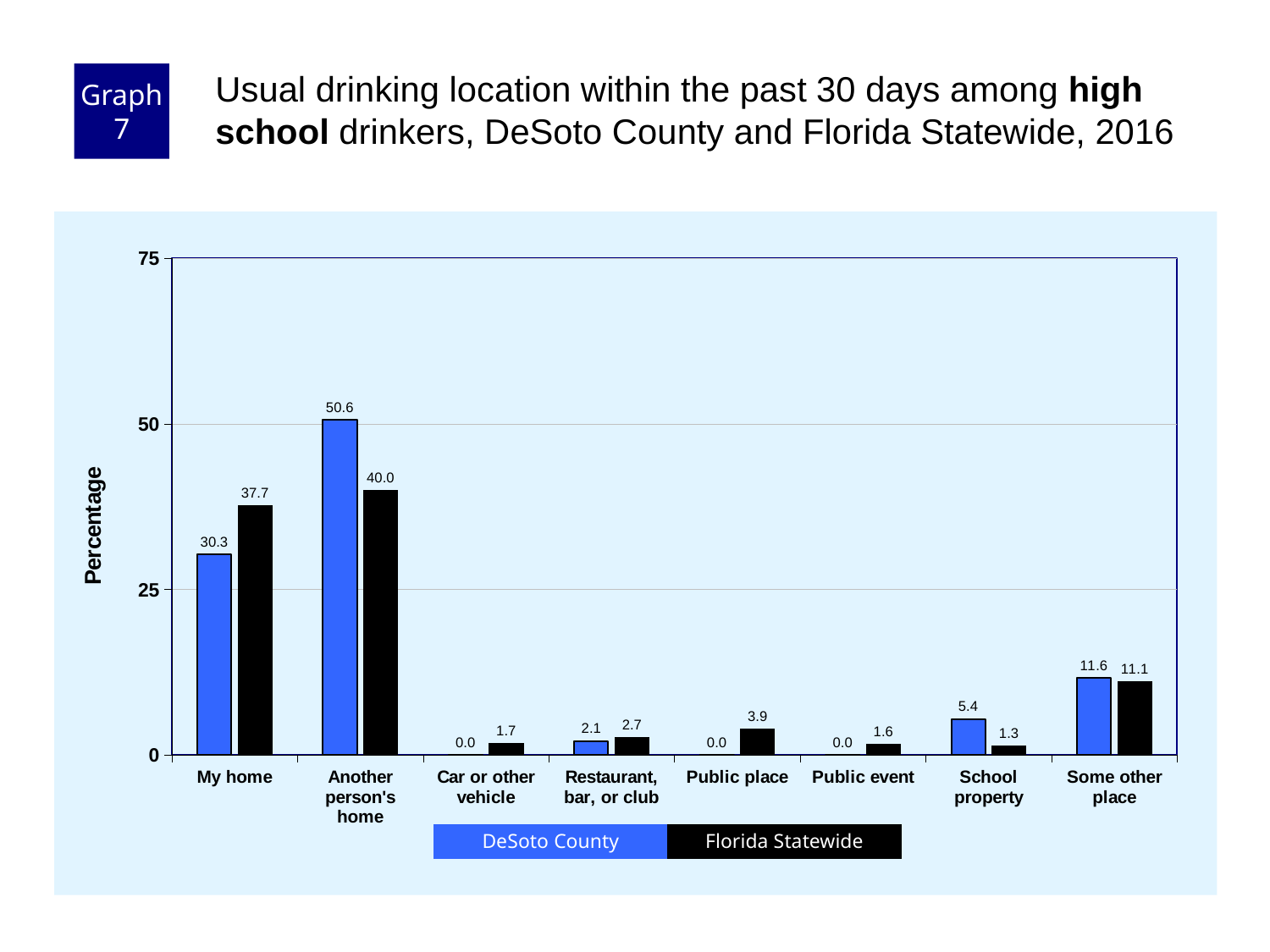
Which category has the highest DeSoto County value? Another person's home Is the DeSoto County value for "Another person's home" greater or less than 50? greater What is the Florida Statewide value for "My home"? 37.7 What is the DeSoto County value for "Another person's home"? 50.6 How many series does the legend list? 2 What is the label on the y axis? Percentage Which category has the lowest Florida Statewide value? School property Which is larger for "My home": DeSoto County or Florida Statewide? Florida Statewide What is the DeSoto County value for "School property"? 5.4 What kind of chart is shown on the slide? Bar chart How many categories are shown on the x axis? 8 What is the difference between the DeSoto County and Florida Statewide values for "Another person's home"? 10.6